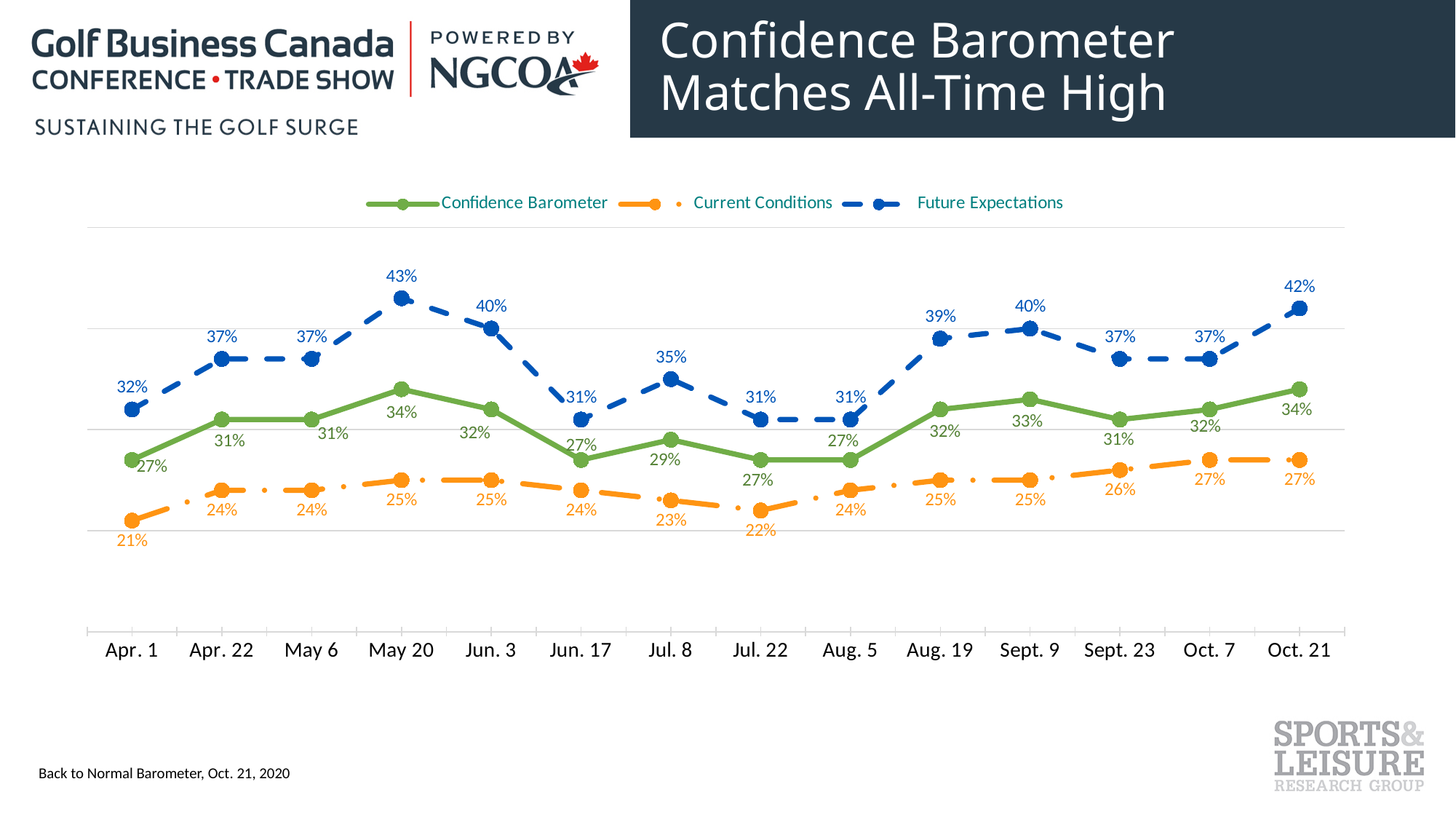
On which date is Current Conditions at its lowest? Apr. 1 Does Current Conditions rise or fall from Aug. 5 to Oct. 21? Rise How many dates are plotted on the x axis? 14 By how much did the Confidence Barometer change from Apr. 1 to Oct. 21? 7 percentage points What is the Future Expectations value on May 20? 43% On which date does Future Expectations reach its highest value? May 20 What kind of chart is shown on the slide? Line chart How many series does the legend list? 3 What is the Confidence Barometer value on Oct. 21? 34% What is the Current Conditions value on Jul. 22? 22% Which is higher on Jun. 3: Future Expectations or Confidence Barometer? Future Expectations What is the difference between Future Expectations and Current Conditions on May 20? 18 percentage points